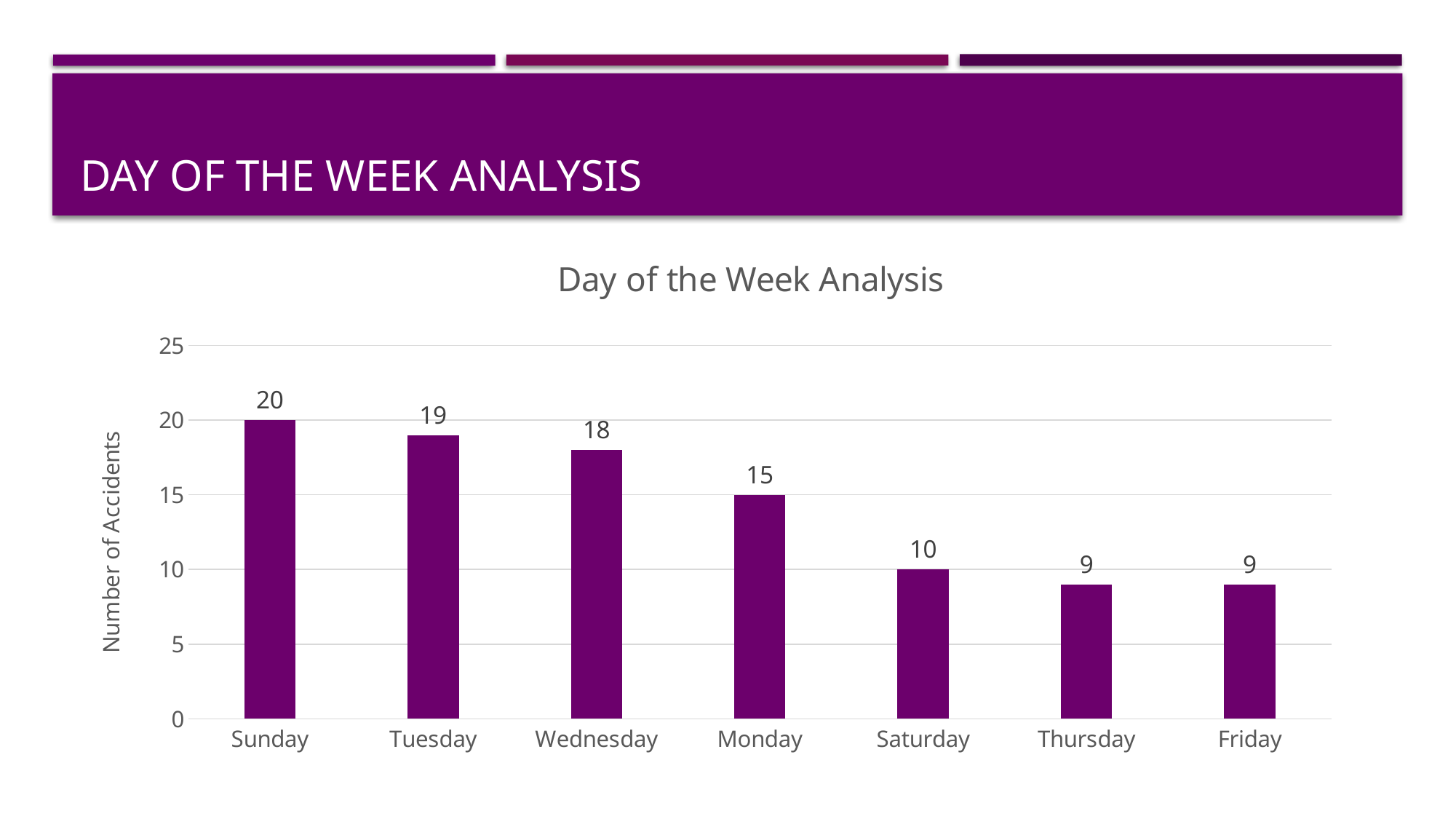
What is the number of accidents for Saturday? 10 Which has more accidents, Wednesday or Saturday? Wednesday Which day has the highest number of accidents? Sunday Do the values rise or fall from left to right along the x axis? Fall How many days are shown on the x axis of the chart? 7 What kind of chart is shown on the slide? Bar chart What is the title of the chart? Day of the Week Analysis What is the difference in the number of accidents between Sunday and Friday? 11 What is the difference in the number of accidents between Tuesday and Monday? 4 What is the number of accidents for Sunday? 20 What is the label of the vertical axis? Number of Accidents What is the number of accidents for Monday? 15